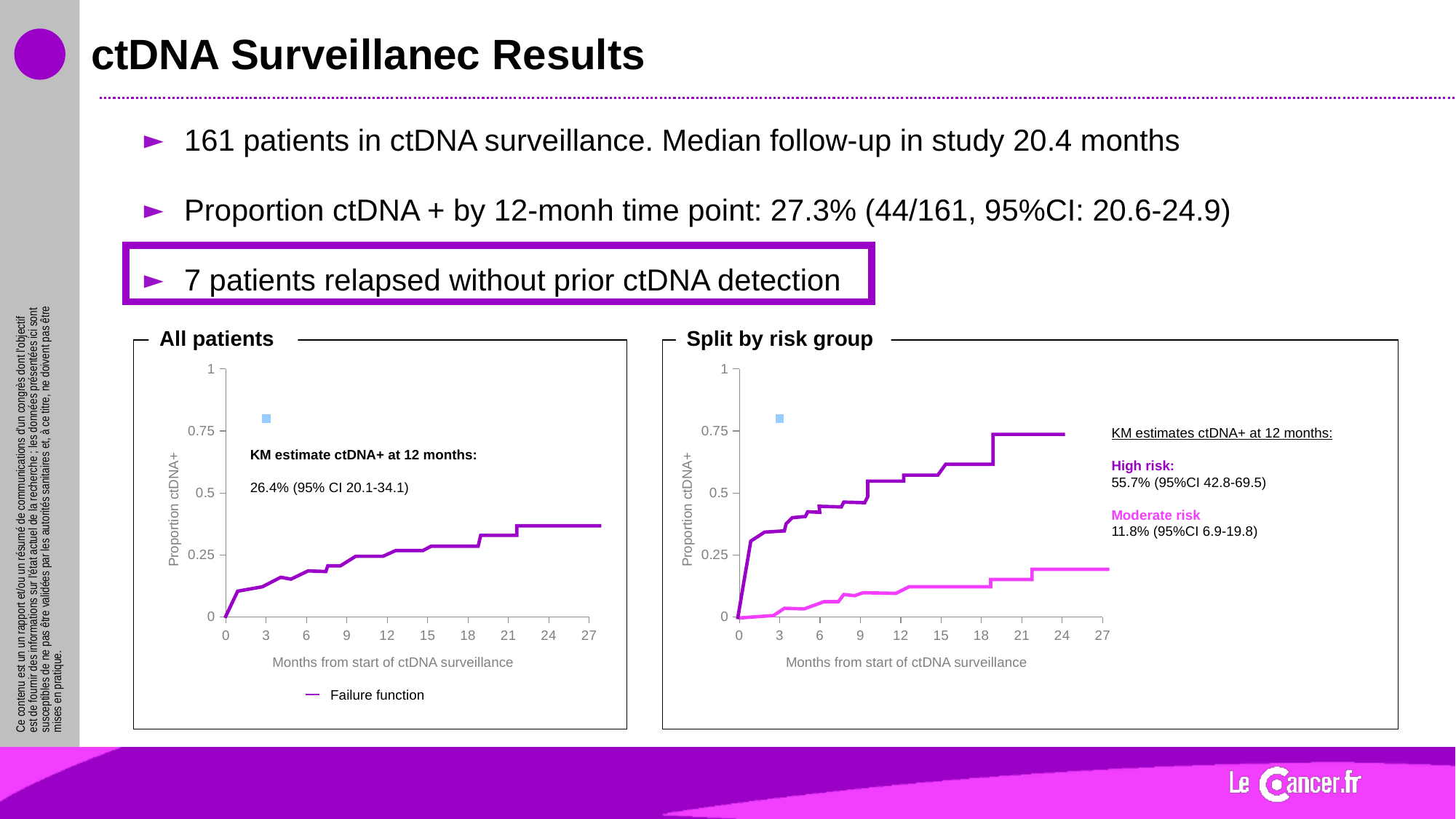
In the 'Split by risk group' chart, what is the KM estimate of ctDNA+ at 12 months for the High risk group? 55.7% What kind of chart is the 'All patients' chart? line chart In the 'All patients' chart, does the failure function rise or fall as months increase? rise In the 'Split by risk group' chart, what is the difference between the High risk and Moderate risk KM estimates at 12 months? 43.9 percentage points In the 'Split by risk group' chart, is the High risk proportion ctDNA+ at 24 months greater or less than 0.5? greater In the 'Split by risk group' chart, which risk group has the higher KM estimate of ctDNA+ at 12 months? High risk In the 'Split by risk group' chart, what is the KM estimate of ctDNA+ at 12 months for the Moderate risk group? 11.8% In the 'All patients' chart, what is the KM estimate of ctDNA+ at 12 months? 26.4% What is the x-axis label of the 'Split by risk group' chart? Months from start of ctDNA surveillance In the 'All patients' chart, what is the single legend entry? Failure function In the 'All patients' chart, what is the 95% CI given for the KM estimate at 12 months? 20.1-34.1 In the 'All patients' chart, is the proportion ctDNA+ at 24 months greater or less than 0.25? greater